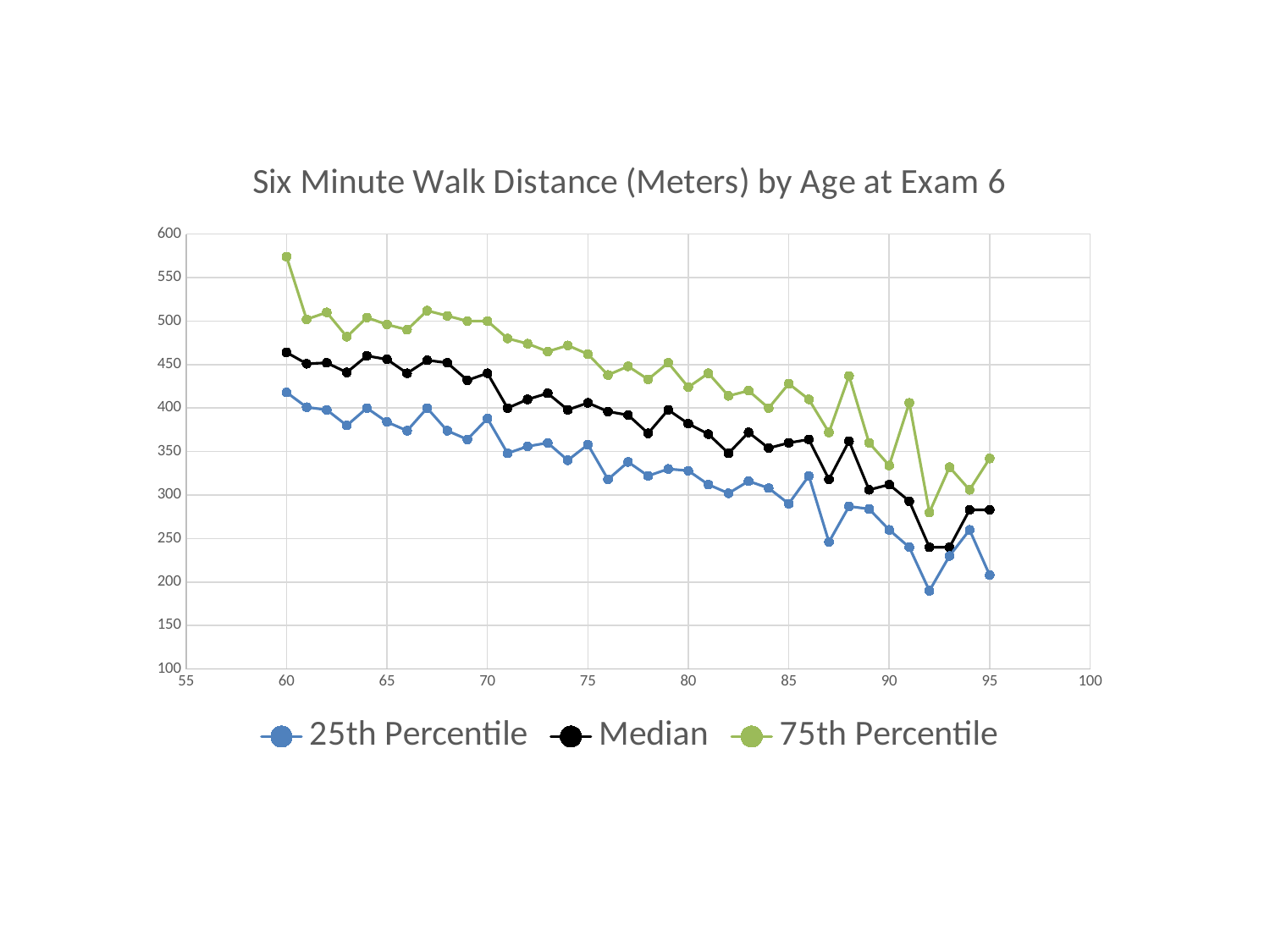
Which series is drawn in green? 75th Percentile What kind of chart is shown on the slide? Line chart At age 60, which is larger: the 75th Percentile value or the 25th Percentile value? 75th Percentile Do the values for the Median series generally rise or fall as age increases? Fall Is the 75th Percentile value at age 60 greater or less than 550? greater At which age does the 75th Percentile series reach its highest value? 60 Is the 75th Percentile value at age 92 greater or less than 300? less How many series does the legend list? 3 At which age does the 25th Percentile series reach its lowest value? 92 Is the Median value at age 60 greater or less than 400? greater What is the title of the chart? Six Minute Walk Distance (Meters) by Age at Exam 6